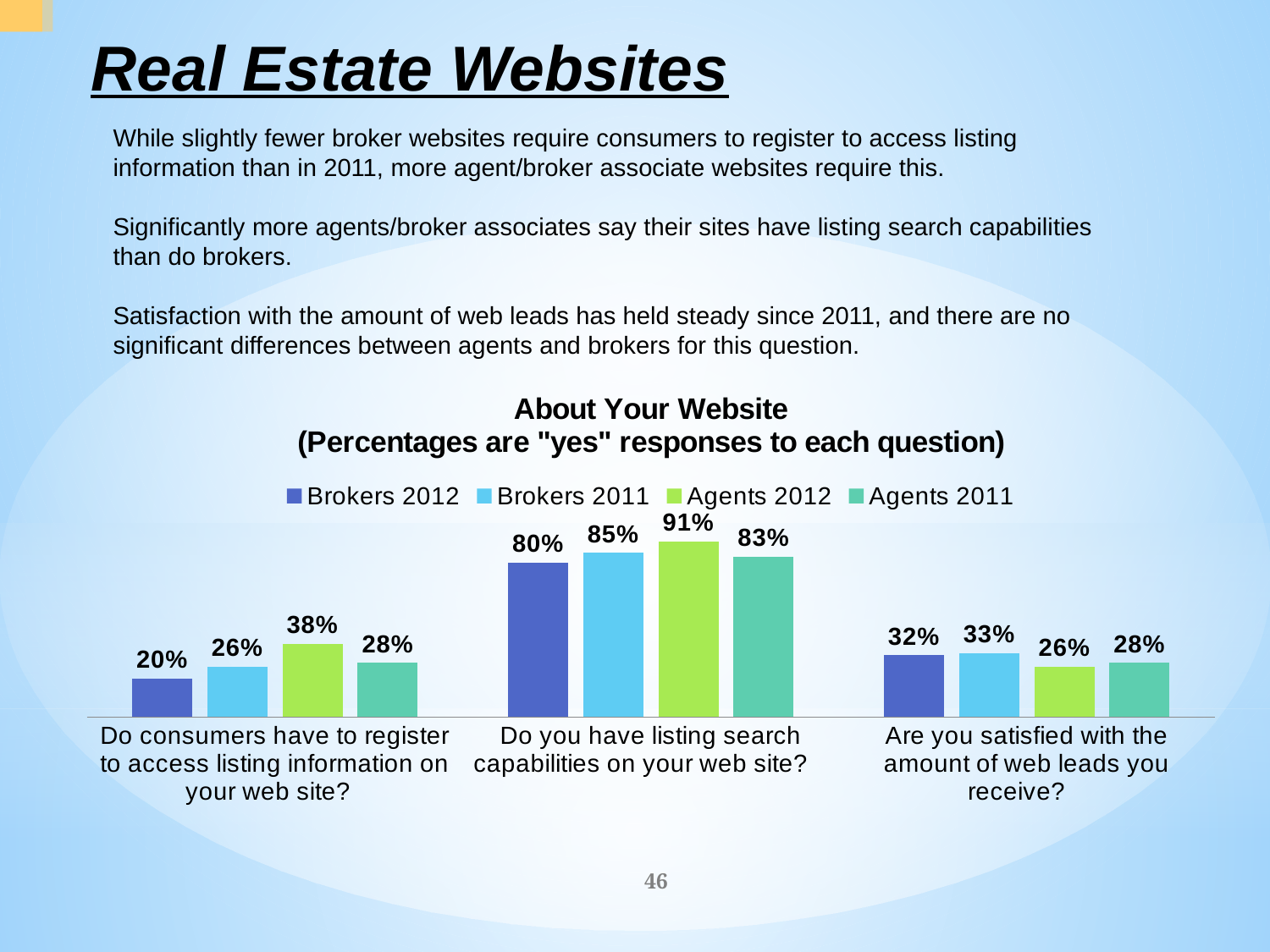
How many series does the legend list? 4 Which series has the lowest value for 'Do consumers have to register to access listing information on your web site?' Brokers 2012 How many question categories are shown on the x axis? 3 What percentage of Brokers 2012 said consumers have to register to access listing information on their web site? 20% For 'Are you satisfied with the amount of web leads you receive?', which is larger: Brokers 2012 or Agents 2012? Brokers 2012 Which series has the highest value for 'Do you have listing search capabilities on your web site?' Agents 2012 What is the difference between Brokers 2011 and Brokers 2012 for 'Do you have listing search capabilities on your web site?' 5% What percentage of Agents 2012 said they have listing search capabilities on their web site? 91% What is the difference between Agents 2012 and Agents 2011 for 'Do consumers have to register to access listing information on your web site?' 10% What percentage of Brokers 2011 said they are satisfied with the amount of web leads they receive? 33% What is the title of the chart? About Your Website (Percentages are "yes" responses to each question) What kind of chart is shown on the slide? Bar chart